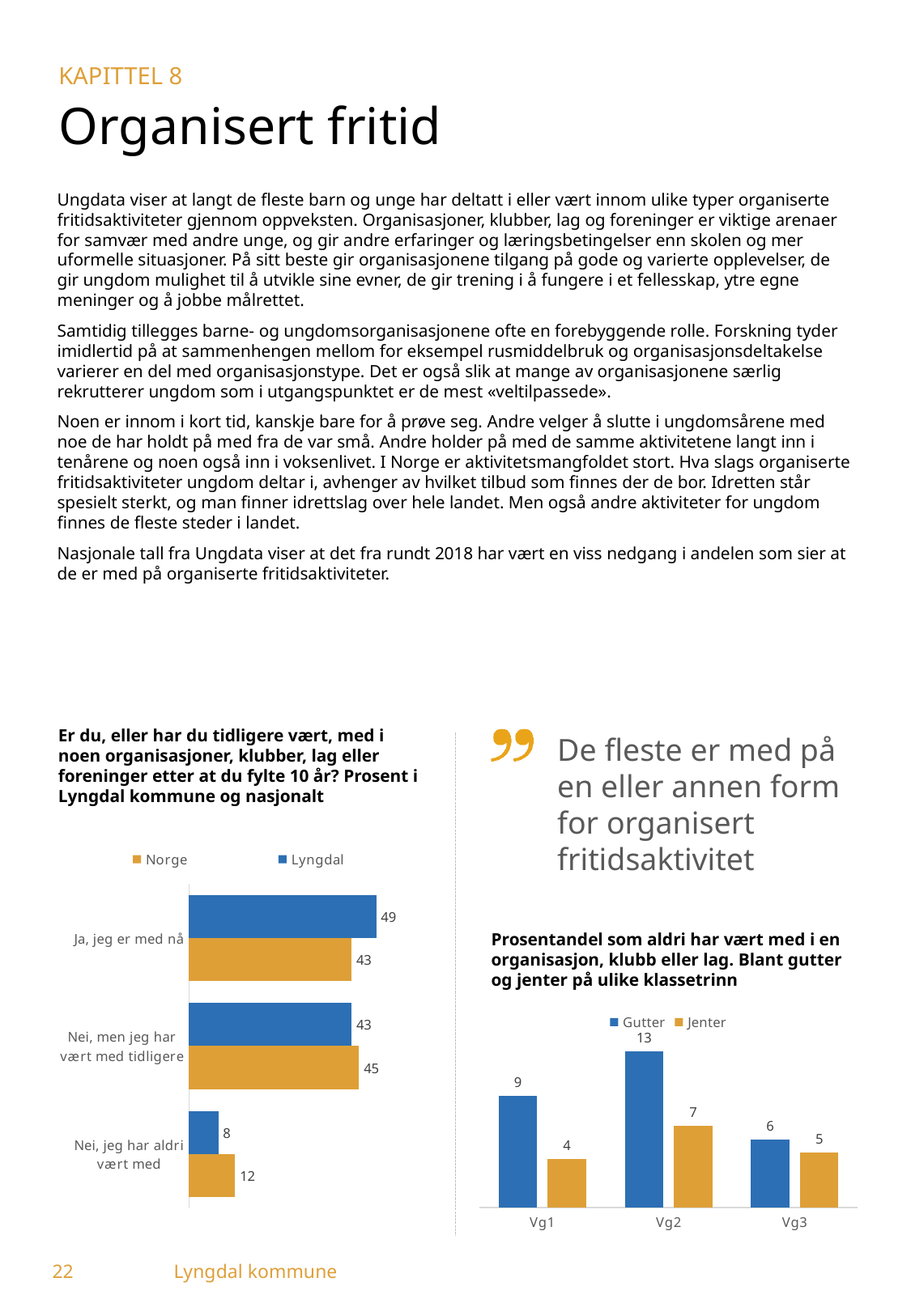
What kind of chart is the left chart? Bar chart In the right chart, which class level has the highest Gutter value? Vg2 In the left chart, what is the difference between the Norge and Lyngdal values for "Nei, men jeg har vært med tidligere"? 2 In the left chart, which category has the lowest Lyngdal value? Nei, jeg har aldri vært med In the right chart ("Prosentandel som aldri har vært med i en organisasjon..."), what is the Gutter value for Vg2? 13 In the right chart, how many class levels are shown on the x axis? 3 In the left chart, how many series does the legend list? 2 In the left chart, which is larger for "Ja, jeg er med nå": Norge or Lyngdal? Lyngdal In the left chart, what is the Norge value for "Nei, jeg har aldri vært med"? 12 In the right chart, what is the difference between the Gutter and Jenter values for Vg2? 6 In the left chart ("Er du, eller har du tidligere vært, med i noen organisasjoner..."), what is the Lyngdal value for "Ja, jeg er med nå"? 49 In the right chart, what is the Jenter value for Vg1? 4